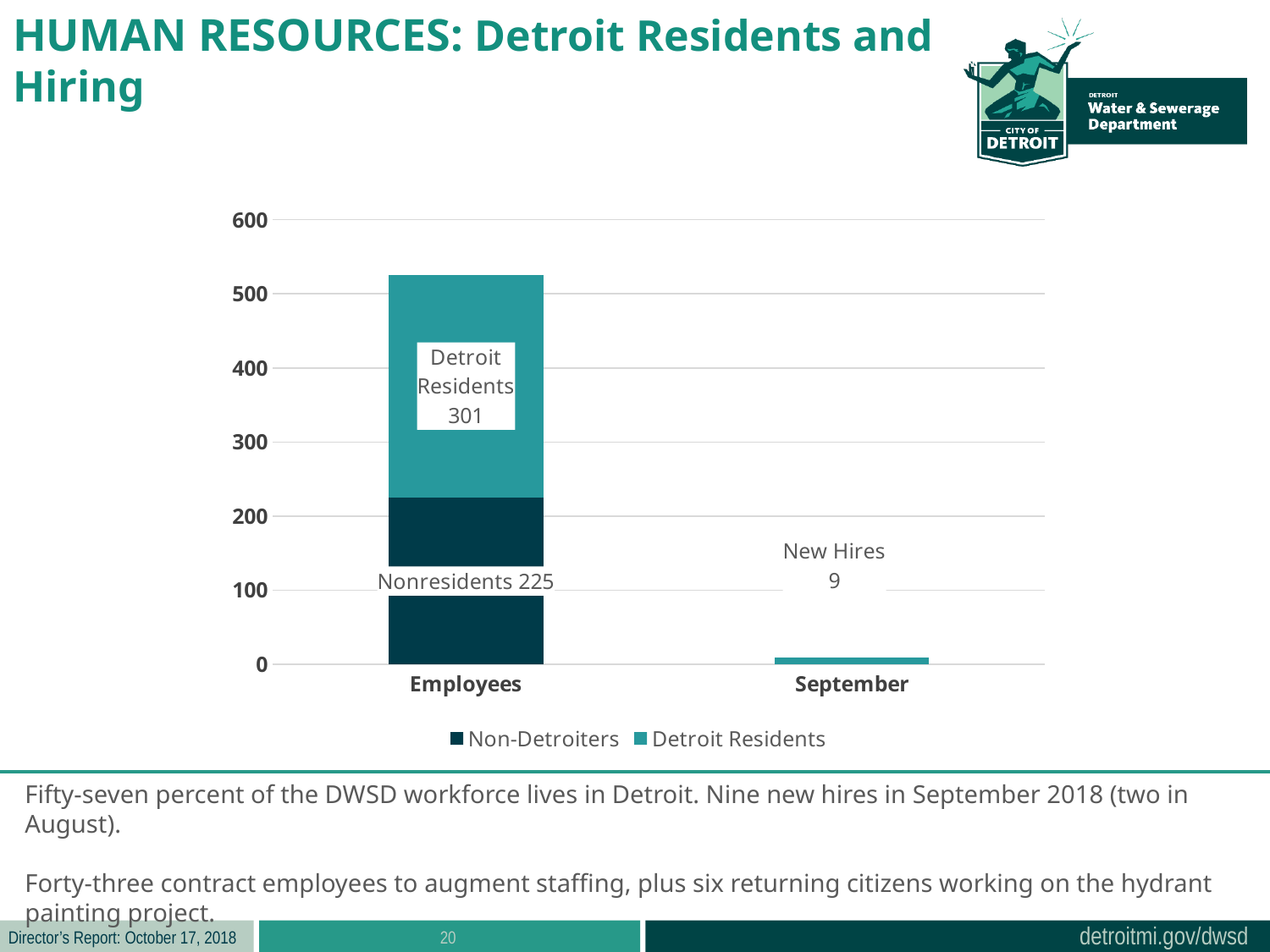
How many series does the chart legend list? 2 What are the two entries in the chart legend? Non-Detroiters and Detroit Residents How many categories are shown on the x axis of the chart? 2 What kind of chart is shown on the slide? Stacked bar chart What is the value labelled New Hires for September? 9 In the Employees bar, which segment is larger: Detroit Residents or Nonresidents? Detroit Residents What is the difference between the Detroit Residents value (301) and the Nonresidents value (225) in the Employees bar? 76 How many Detroit Residents are shown in the Employees bar? 301 Which category has the taller bar, Employees or September? Employees How many Nonresidents are shown in the Employees bar? 225 Is the total height of the Employees bar greater or less than 500? greater What is the total of the stacked Employees bar (Nonresidents plus Detroit Residents)? 526